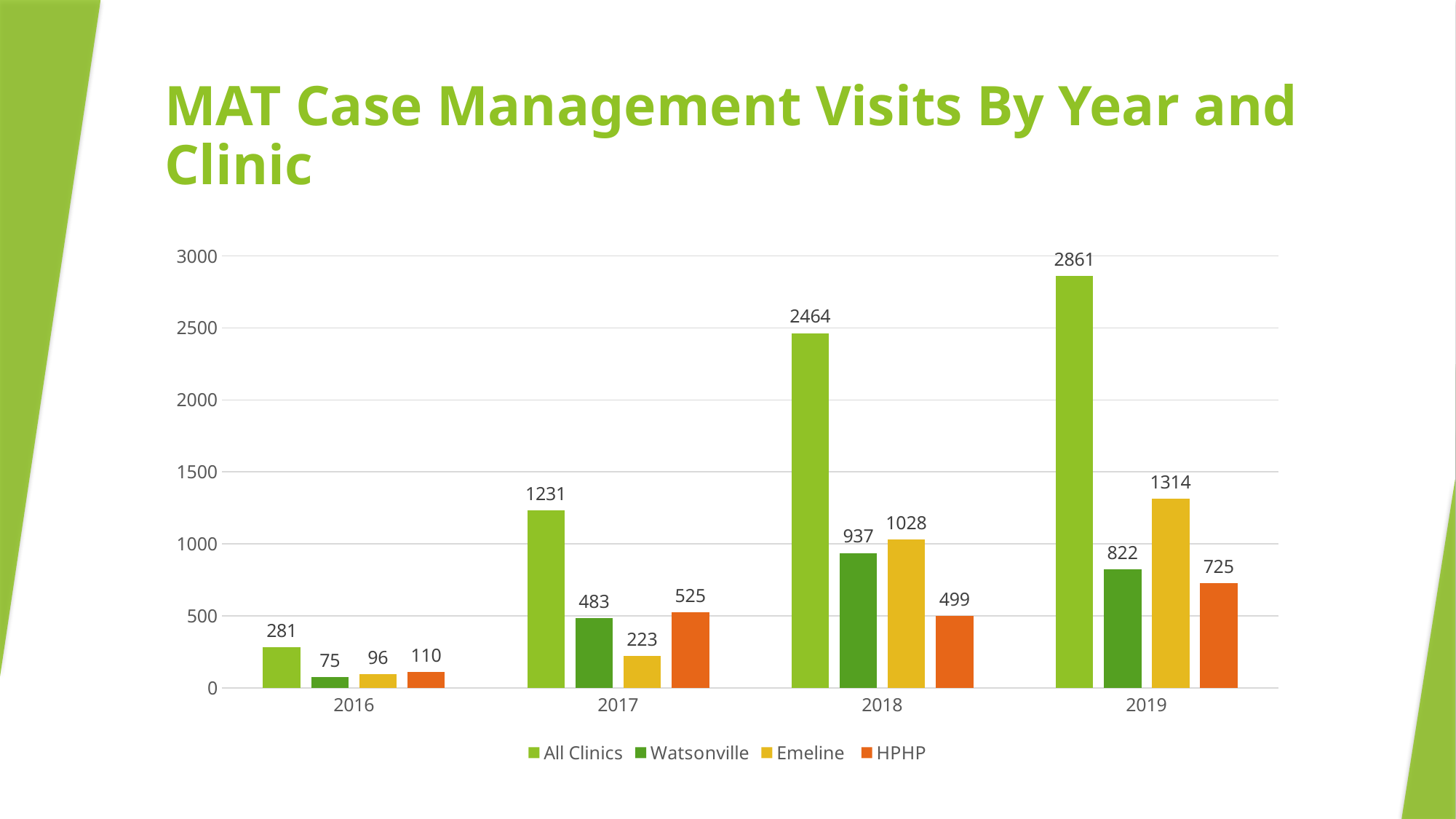
Which is larger in 2019, Watsonville or Emeline? Emeline What kind of chart is shown on the slide? bar chart Does the All Clinics value rise or fall from 2016 to 2019? rise What is the value for All Clinics in 2019? 2861 How many series does the legend list? 4 What is the value for Watsonville in 2016? 75 What is the difference between the All Clinics values for 2018 and 2017? 1233 In which year is the All Clinics value highest? 2019 What is the value for Emeline in 2018? 1028 How many years are shown on the x axis? 4 What is the value for HPHP in 2017? 525 In which year is the Emeline value lowest? 2016